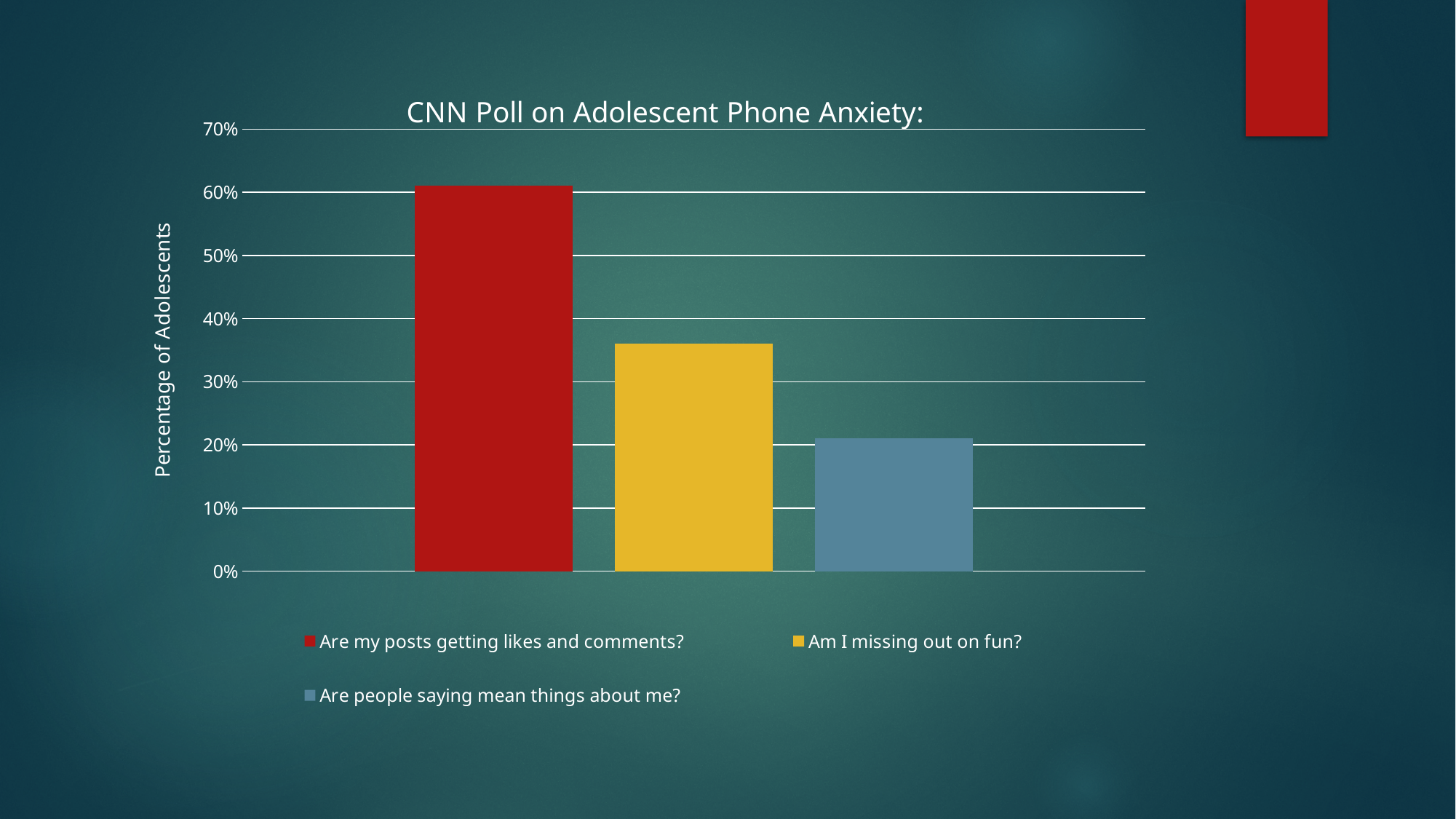
Is the value for "Are people saying mean things about me?" greater or less than 30%? less What is the title of the chart? CNN Poll on Adolescent Phone Anxiety: What kind of chart is shown on the slide? bar chart Which is larger: the value for "Am I missing out on fun?" or the value for "Are people saying mean things about me?" Am I missing out on fun? Is the value for "Are my posts getting likes and comments?" greater or less than 50%? greater How many series does the legend list? 3 Which series has the lowest value? Are people saying mean things about me? What is the label on the vertical axis of the chart? Percentage of Adolescents Do the bar values rise or fall from left to right across the chart? fall How many bars are plotted in the chart? 3 Which series has the highest value? Are my posts getting likes and comments? Is the value for "Am I missing out on fun?" greater or less than 40%? less